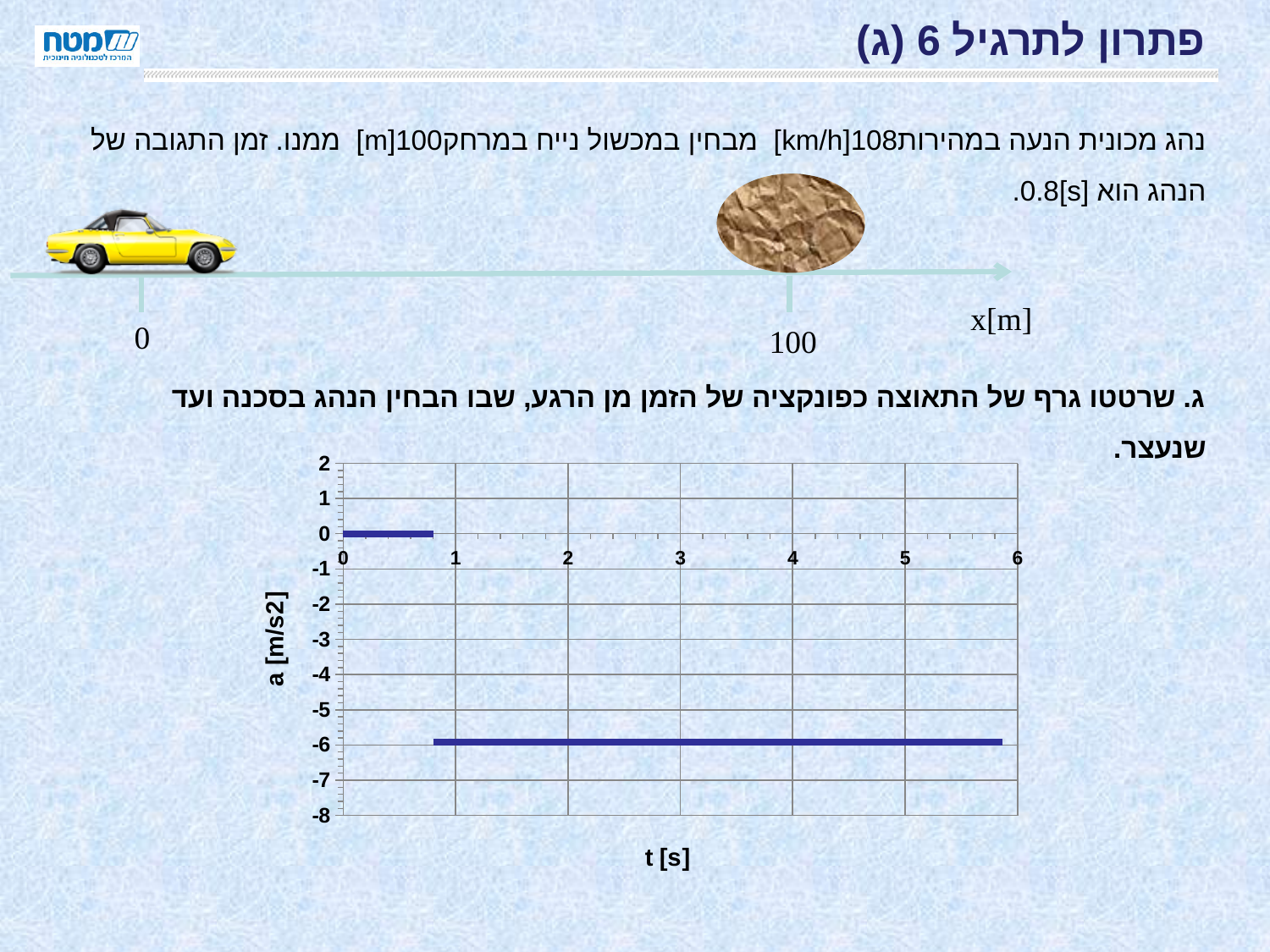
Which is larger, the value of a at t = 0.5 s or the value of a at t = 2 s? t = 0.5 s Is the value of a at t = 3 s greater or less than -7? greater What is the highest value shown on the horizontal axis of the chart? 6 How many horizontal segments does the plotted line consist of? 2 What is the value of a during the first segment of the graph, from t = 0 up to about 0.8 s? 0 What is the label of the vertical axis of the chart? a [m/s2] What is the lowest value shown on the vertical axis of the chart? -8 Is the value of a at t = 5 s greater or less than -4? less Does the value of a rise or fall as t increases along the x axis? fall What kind of chart is shown on the slide? line chart Is the value of a at t = 3 s greater or less than -5? less